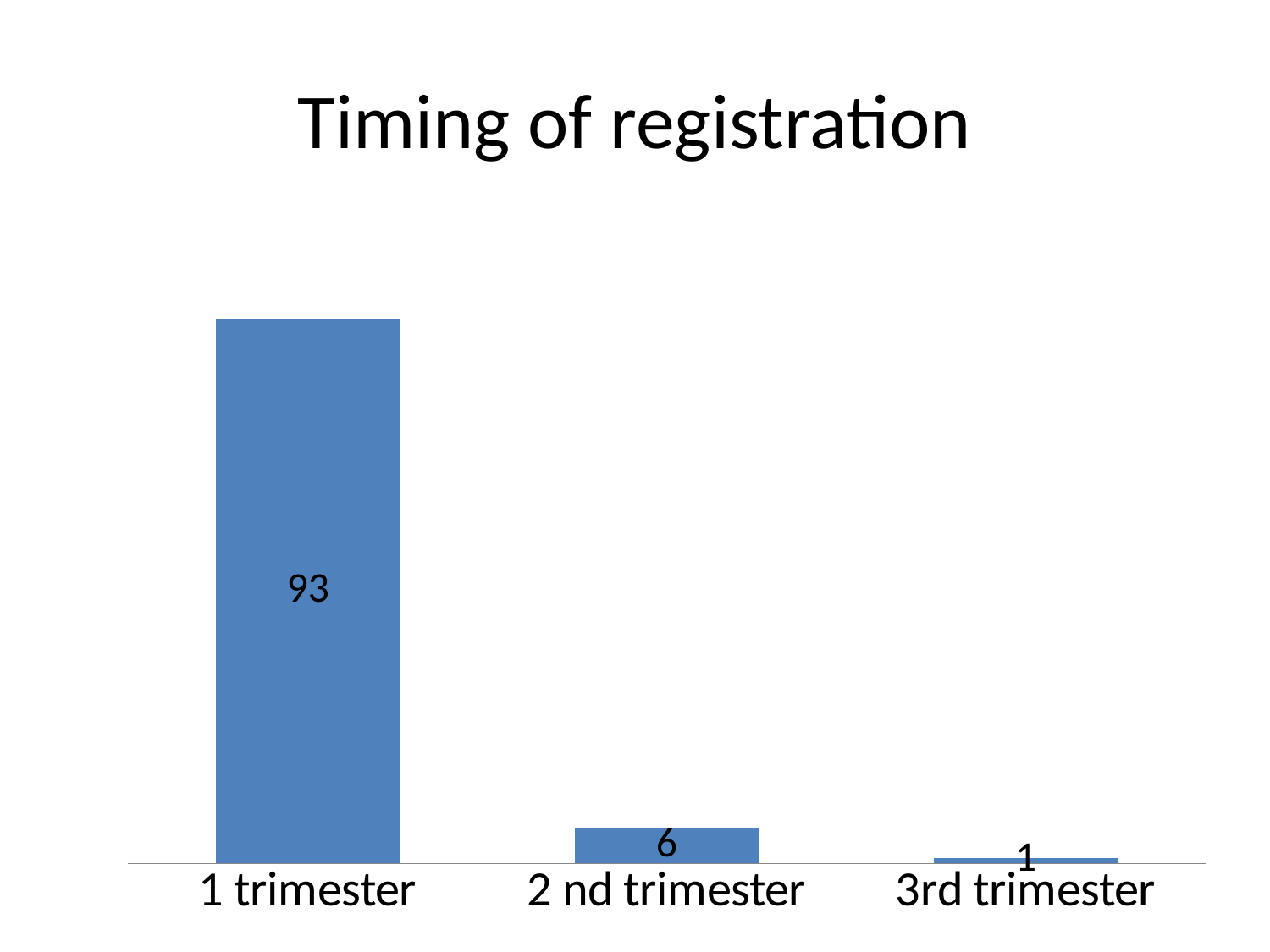
What is the value for 1 trimester? 93 What is the value for 3rd trimester? 1 How many categories are shown on the chart? 3 Do the values rise or fall from left to right along the x axis? fall Which category has the lowest value? 3rd trimester What is the value for 2 nd trimester? 6 What is the title of the chart? Timing of registration What is the difference between the values for 1 trimester and 2 nd trimester? 87 What kind of chart is shown on the slide? bar chart Which is larger, the value for 2 nd trimester or the value for 3rd trimester? 2 nd trimester Which category has the highest value? 1 trimester What is the difference between the values for 2 nd trimester and 3rd trimester? 5